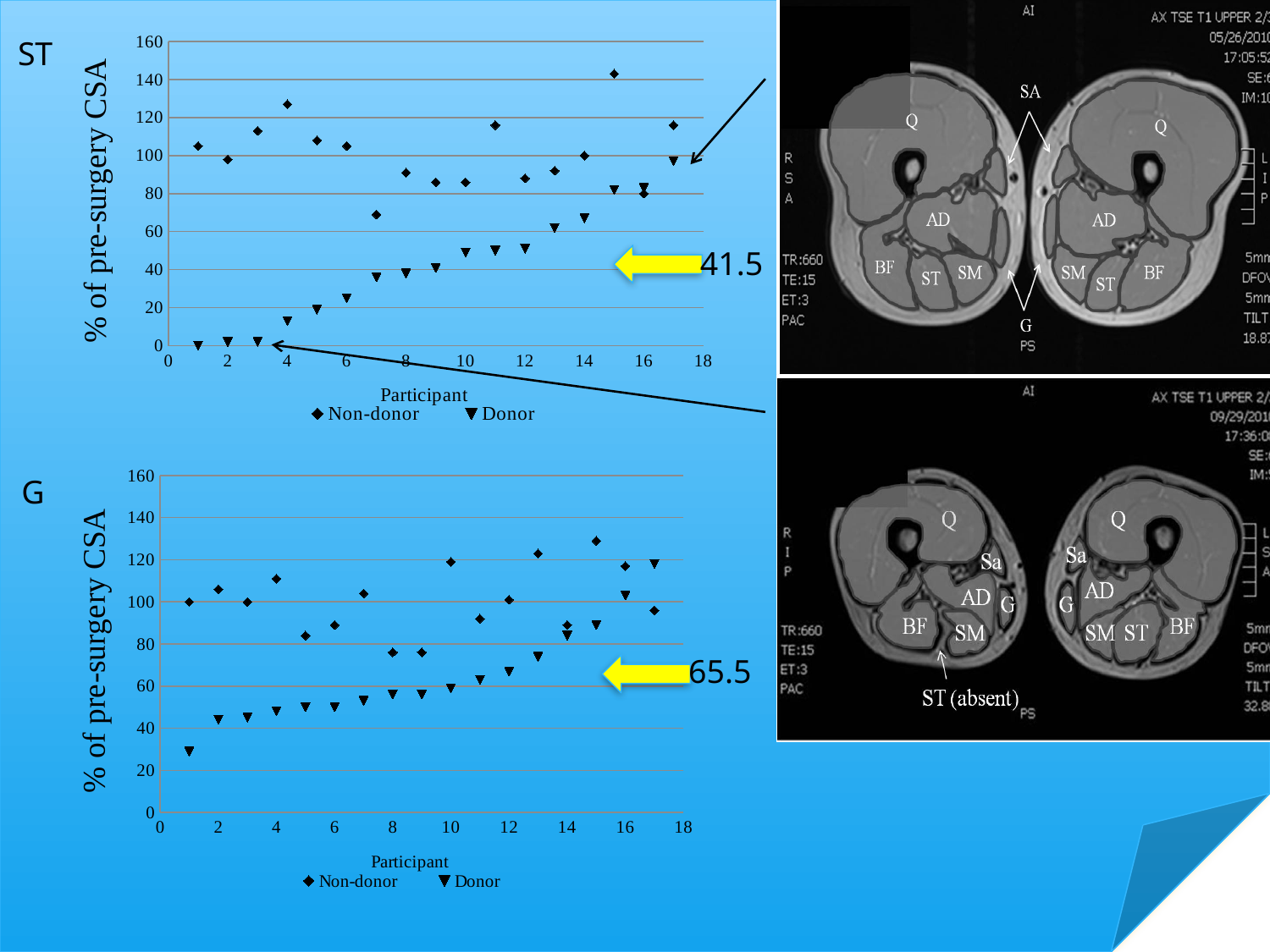
In the ST chart, how many participants are plotted for the Donor series? 17 In the ST chart, do the Donor values generally rise or fall as the participant number increases? rise In the ST chart, for participant 1, which is larger: the Non-donor value or the Donor value? Non-donor In the G chart, which participant has the lowest Donor value? 1 In the ST chart, which participant has the highest Non-donor value? 15 In the G chart, for participant 17, which is larger: the Non-donor value or the Donor value? Donor How many series does the legend of the ST chart list? 2 What kind of chart is the ST chart at the top left of the slide? scatter chart In the ST chart, is the Donor value for participant 1 greater or less than 20? less What is the y-axis label of the G chart? % of pre-surgery CSA In the G chart, is the Donor value for participant 1 greater or less than 40? less In the ST chart, is the Non-donor value for participant 15 greater or less than 120? greater